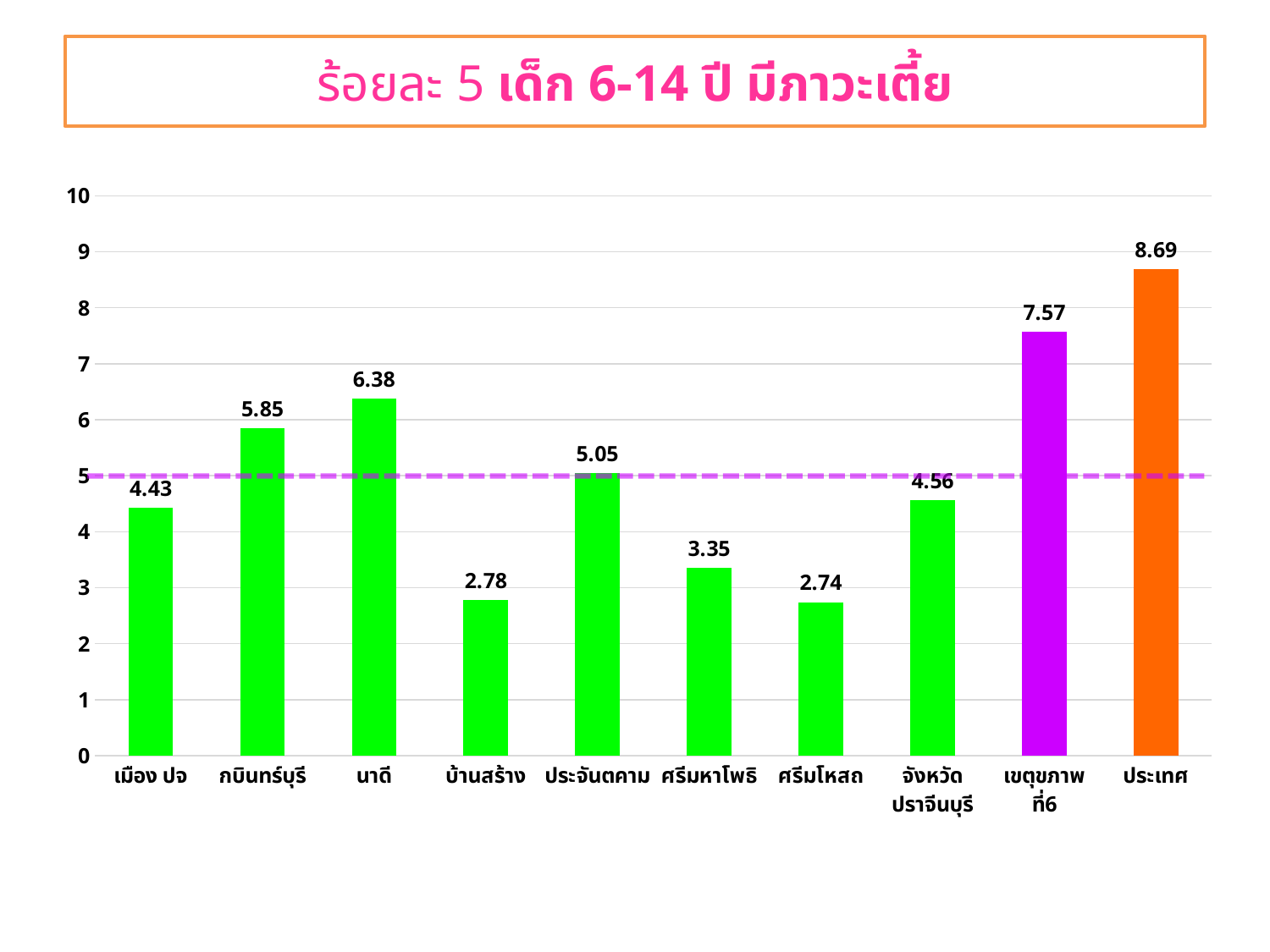
Which category has the highest value? ประเทศ What is the value for นาดี? 6.38 What is the value for จังหวัดปราจีนบุรี? 4.56 Is the value for บ้านสร้าง greater or less than 5? less What kind of chart is shown on the slide? bar chart What is the value for เขตสุขภาพที่6? 7.57 What is the difference between the values for ประเทศ and เขตสุขภาพที่6? 1.12 Which is larger, the value for กบินทร์บุรี or the value for เมือง ปจ? กบินทร์บุรี Which category has the lowest value? ศรีมโหสถ How many categories are shown on the x axis? 10 At what value is the horizontal dashed line drawn? 5 What is the value for ประเทศ? 8.69